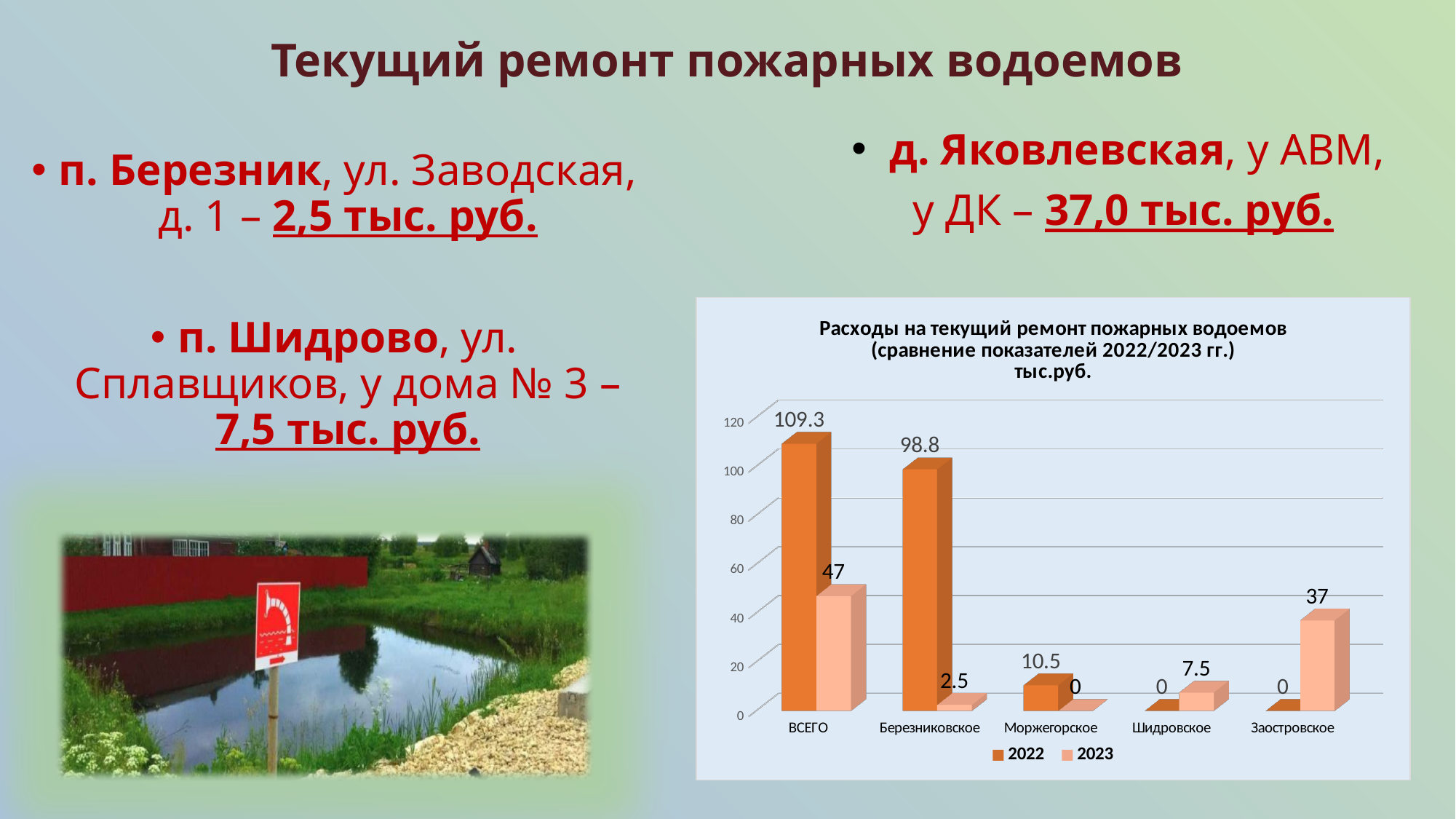
Which category has the highest value in the 2023 series, excluding ВСЕГО? Заостровское What is the value for Заостровское in the 2023 series? 37 What is the value for ВСЕГО in the 2023 series? 47 How many categories are shown on the x axis of the chart? 5 What is the difference between the 2022 and 2023 values for ВСЕГО? 62.3 How many series does the chart legend list? 2 What is the value for Березниковское in the 2022 series? 98.8 What is the value for Шидровское in the 2022 series? 0 What kind of chart is shown on the slide? Bar chart Which is larger for Моржегорское: the 2022 value or the 2023 value? 2022 What unit is stated in the chart title? тыс.руб. Which category has the lowest value in the 2023 series? Моржегорское